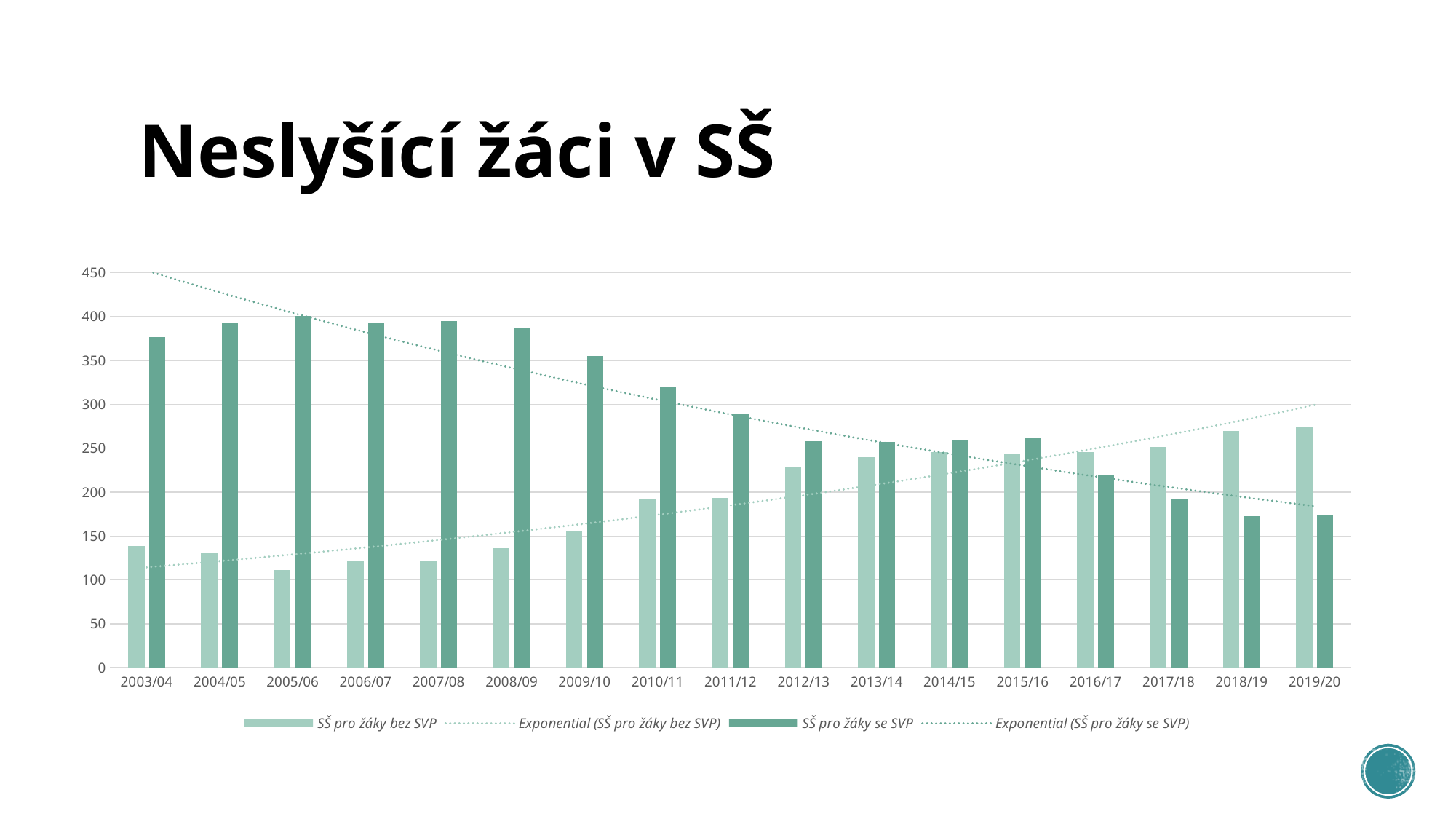
Do the values for SŠ pro žáky se SVP generally rise or fall from 2003/04 to 2019/20? fall What kind of chart is shown on the slide? bar chart How many school years are shown on the x axis of the chart? 17 Is the value for SŠ pro žáky bez SVP in 2003/04 greater or less than 150? less Is the value for SŠ pro žáky bez SVP in 2010/11 greater or less than 200? less In 2019/20, which series has the larger value: SŠ pro žáky bez SVP or SŠ pro žáky se SVP? SŠ pro žáky bez SVP Is the value for SŠ pro žáky se SVP in 2016/17 greater or less than 200? greater In 2003/04, which series has the larger value: SŠ pro žáky bez SVP or SŠ pro žáky se SVP? SŠ pro žáky se SVP What is the title of the slide containing the chart? Neslyšící žáci v SŠ In which school year is the value for SŠ pro žáky bez SVP the lowest? 2005/06 How many entries does the chart's legend list? 4